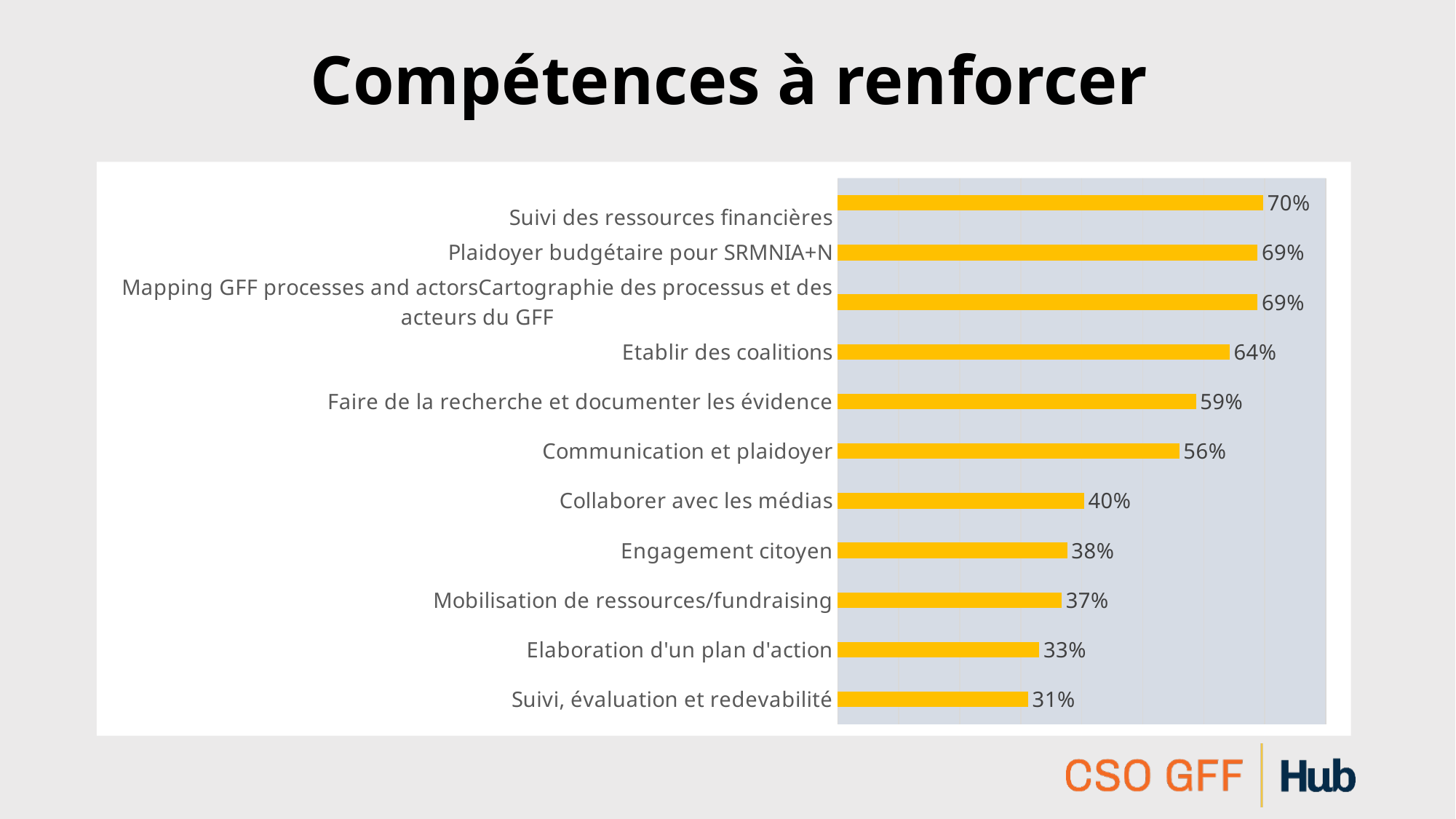
What is the title of the slide? Compétences à renforcer Which category has the highest value? Suivi des ressources financières What is the difference between the values for Etablir des coalitions and Communication et plaidoyer? 8% What is the value for Elaboration d'un plan d'action? 33% What kind of chart is shown on the slide? Bar chart What is the value for Faire de la recherche et documenter les évidence? 59% What is the difference between the values for Suivi des ressources financières and Suivi, évaluation et redevabilité? 39% Which category has the lowest value? Suivi, évaluation et redevabilité What is the value for Suivi des ressources financières? 70% Which is larger, the value for Engagement citoyen or the value for Mobilisation de ressources/fundraising? Engagement citoyen What is the value for Collaborer avec les médias? 40% How many categories are shown in the chart? 11